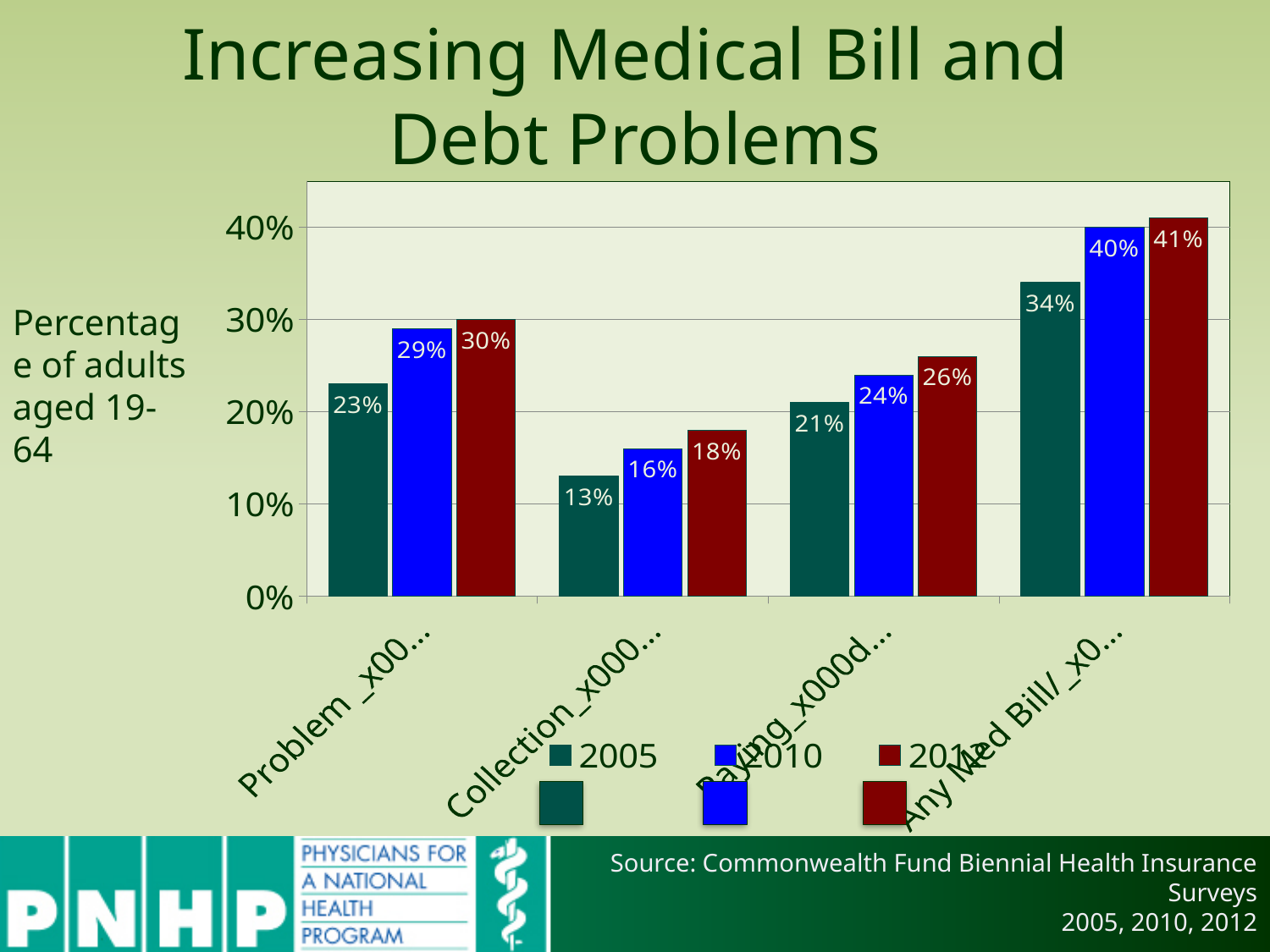
What is the 2005 value for the first category (Problem...)? 23% Within the Collection... category, do the values rise or fall from 2005 to 2012? Rise Which is larger: the 2010 value for Problem... or the 2012 value for Paying...? 2010 value for Problem... (29%) Which category has the highest 2012 value? Any Med Bill... What kind of chart is shown on the slide? Bar chart Which category has the lowest 2005 value? Collection... How many series does the legend list? 3 How many categories are shown on the x axis? 4 What is the 2010 value for the Collection... category? 16% What is the difference between the 2012 and 2005 values for the Any Med Bill... category? 7% What is the 2012 value for the Paying... category? 26% What is the 2010 value for the Any Med Bill... category? 40%